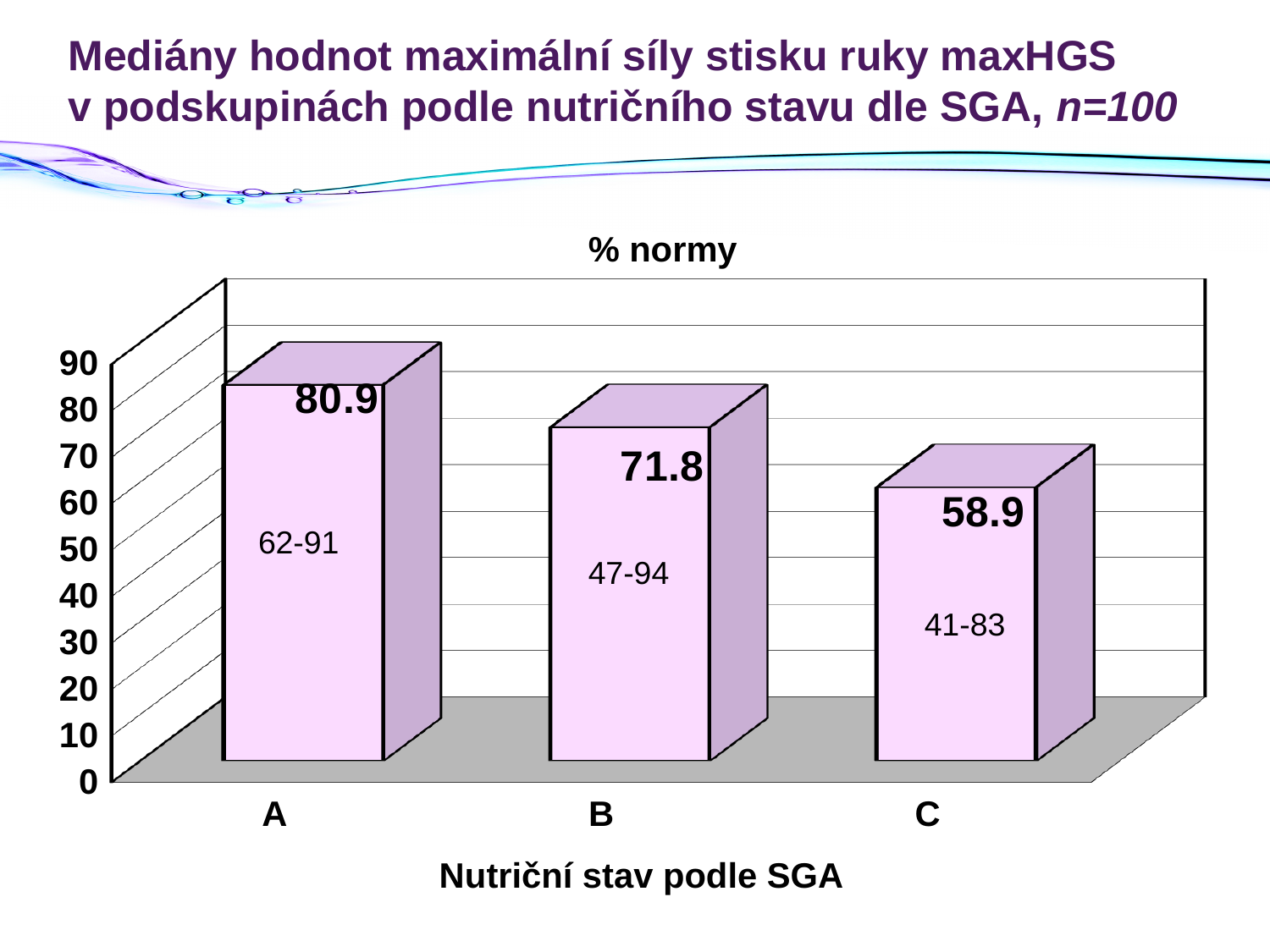
How many categories are shown on the x axis? 3 What is the difference between the values for A and B? 9.1 What is the x-axis title of the chart? Nutriční stav podle SGA Do the values rise or fall from A to C along the x axis? fall What is the difference between the values for A and C? 22 What kind of chart is shown on the slide? bar chart What is the value for category A? 80.9 Which is larger, the value for B or the value for C? B What is the value for category C? 58.9 Which category has the lowest value? C What is the value for category B? 71.8 Which category has the highest value? A